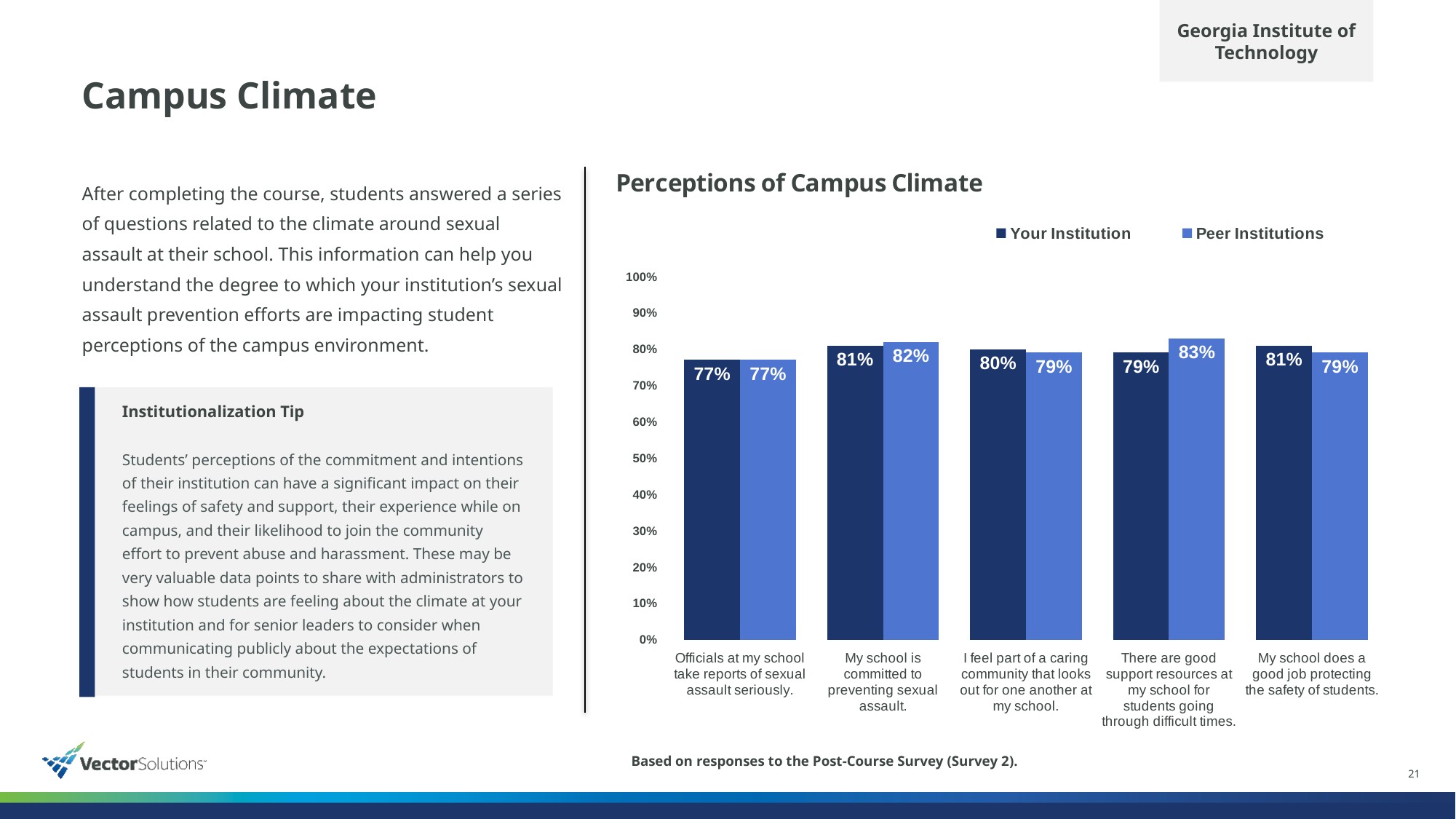
What is the title of the chart? Perceptions of Campus Climate Which category has the highest Peer Institutions value? There are good support resources at my school for students going through difficult times. What is the value for Peer Institutions for "There are good support resources at my school for students going through difficult times"? 83% Which category has the lowest Your Institution value? Officials at my school take reports of sexual assault seriously. For "I feel part of a caring community that looks out for one another at my school", which is larger: Your Institution or Peer Institutions? Your Institution How many series does the legend list? 2 How many categories are shown on the x axis? 5 What is the value for Your Institution for "Officials at my school take reports of sexual assault seriously"? 77% What is the value for Your Institution for "My school does a good job protecting the safety of students"? 81% What kind of chart is shown on the slide? Bar chart What is the value for Peer Institutions for "My school is committed to preventing sexual assault"? 82% What is the difference between the Peer Institutions and Your Institution values for "There are good support resources at my school for students going through difficult times"? 4%